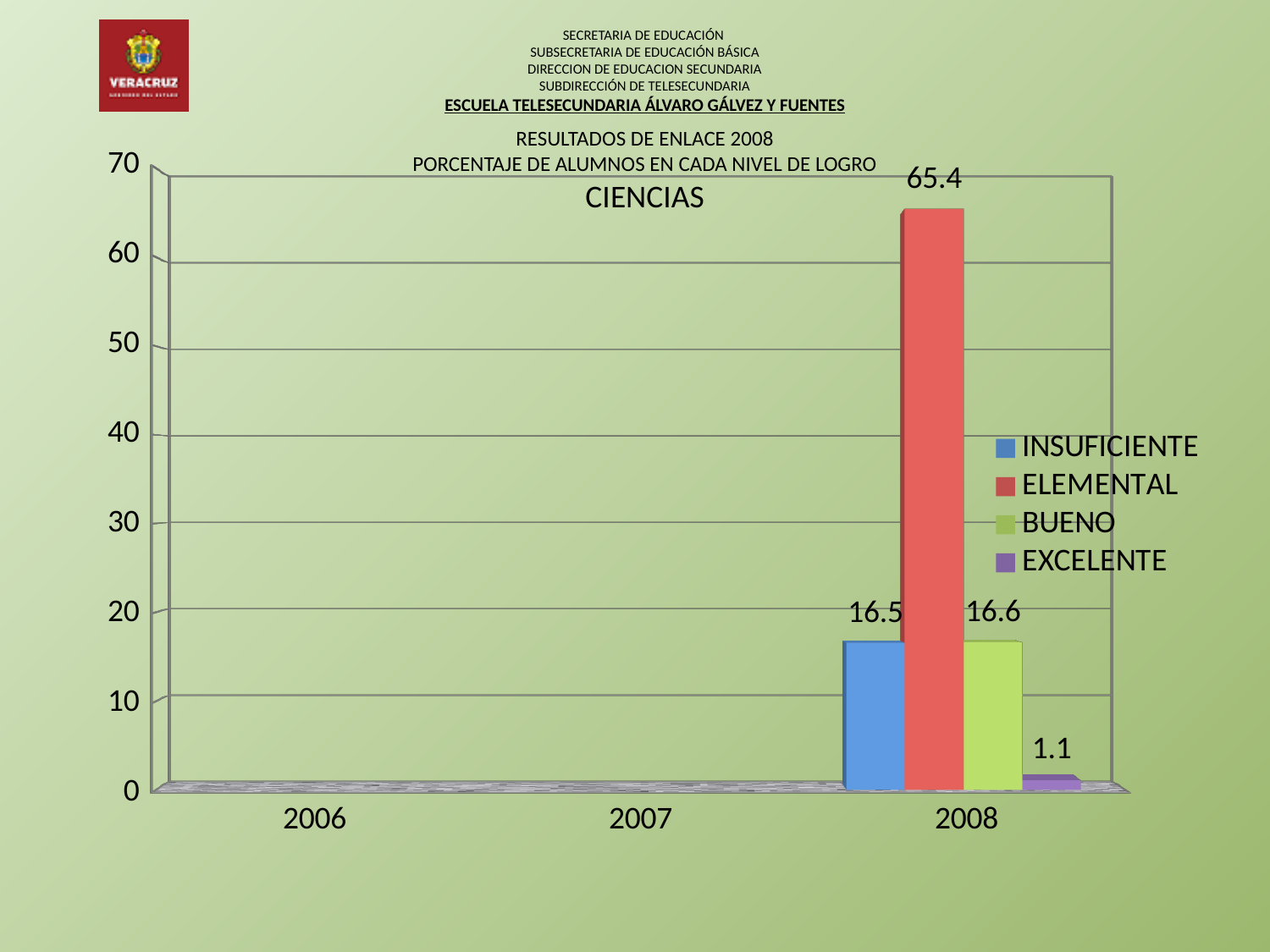
What is the value for INSUFICIENTE in 2008? 16.5 How many year categories are shown on the x axis? 3 What is the value for ELEMENTAL in 2008? 65.4 How many series does the legend list? 4 What kind of chart is shown on the slide? Bar chart What is the value for EXCELENTE in 2008? 1.1 What is the difference between the ELEMENTAL and INSUFICIENTE values in 2008? 48.9 What is the difference between the BUENO and EXCELENTE values in 2008? 15.5 Which level has the lowest value in 2008? EXCELENTE Which is larger in 2008, ELEMENTAL or BUENO? ELEMENTAL What is the value for BUENO in 2008? 16.6 Which level has the highest value in 2008? ELEMENTAL